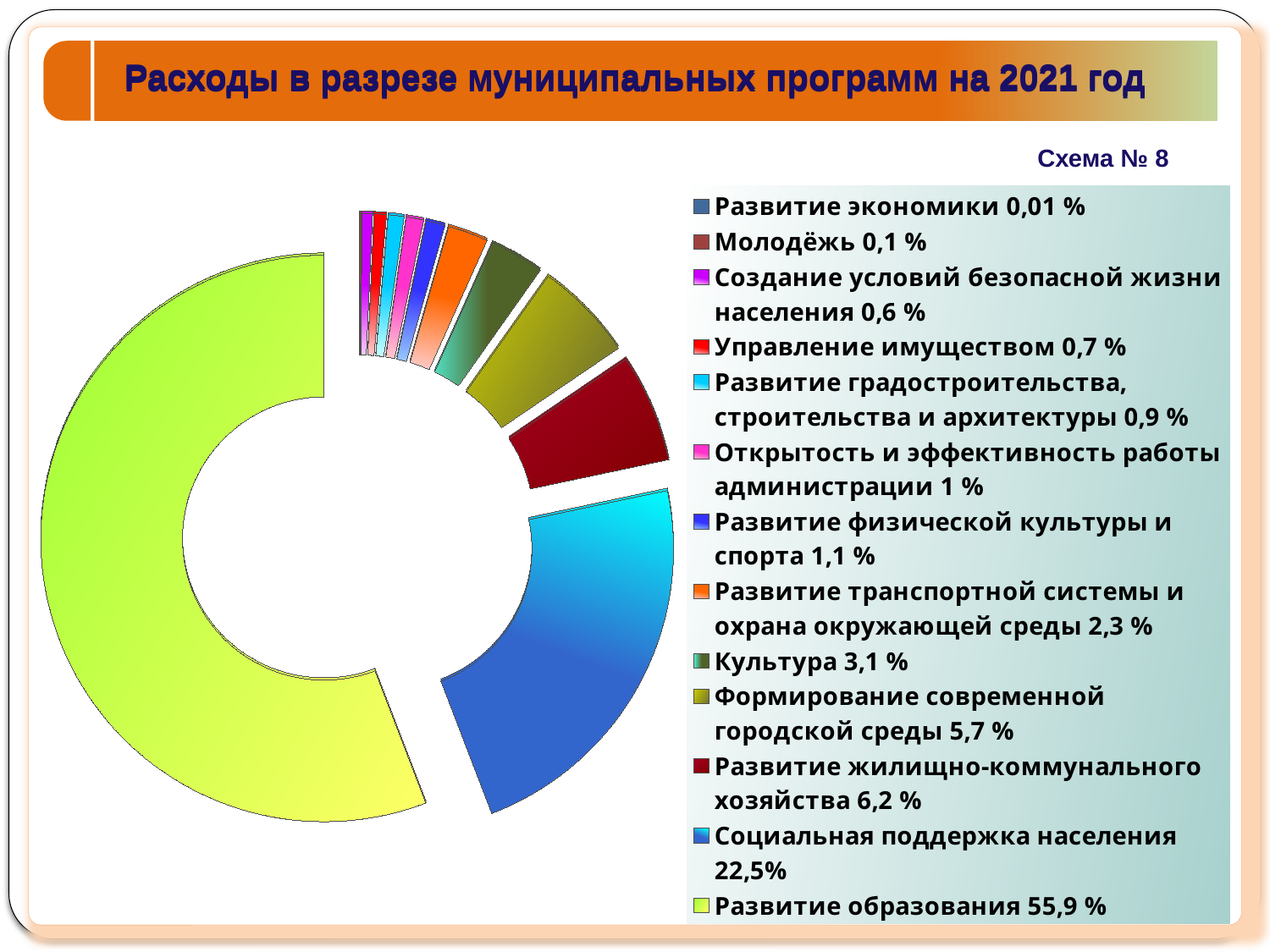
What is the difference between the shares of Развитие образования and Социальная поддержка населения? 33,4 % What type of chart is shown on the slide? Doughnut (pie) chart What is the difference between Развитие жилищно-коммунального хозяйства and Формирование современной городской среды? 0,5 % What is the value shown for Социальная поддержка населения? 22,5% What percentage is shown for Культура? 3,1 % Which municipal programme has the smallest share of expenditure? Развитие экономики What share of expenditure does Развитие образования account for? 55,9 % Which is larger: Культура or Развитие транспортной системы и охрана окружающей среды? Культура Which municipal programme has the largest share of expenditure? Развитие образования How many municipal programmes are listed in the legend? 13 What is the value for Развитие жилищно-коммунального хозяйства? 6,2 % What is the title of the chart on the slide? Расходы в разрезе муниципальных программ на 2021 год